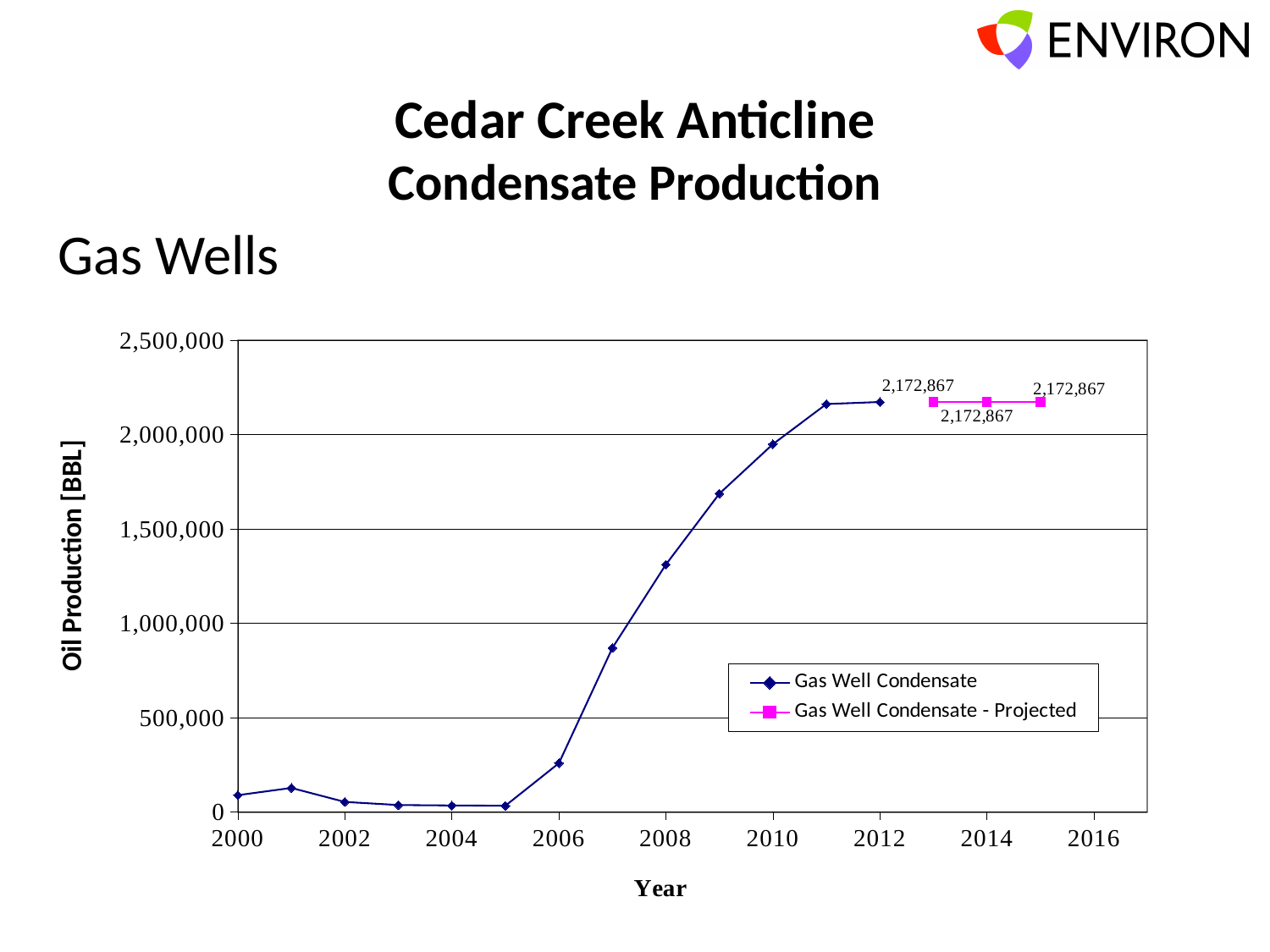
What is the title of the y axis? Oil Production [BBL] What is the projected Gas Well Condensate value for 2013? 2,172,867 How many data points does the Gas Well Condensate - Projected series have? 3 Is the Gas Well Condensate value for 2011 greater or less than 2,000,000? greater How many series does the legend list? 2 What is the projected Gas Well Condensate value for 2015? 2,172,867 Does the Gas Well Condensate series rise or fall between 2005 and 2011? rise What kind of chart is shown on the slide? line chart Is the Gas Well Condensate value for 2008 greater or less than 1,000,000? greater Is the Gas Well Condensate value for 2007 greater or less than 1,000,000? less Which year has the larger Gas Well Condensate value, 2007 or 2009? 2009